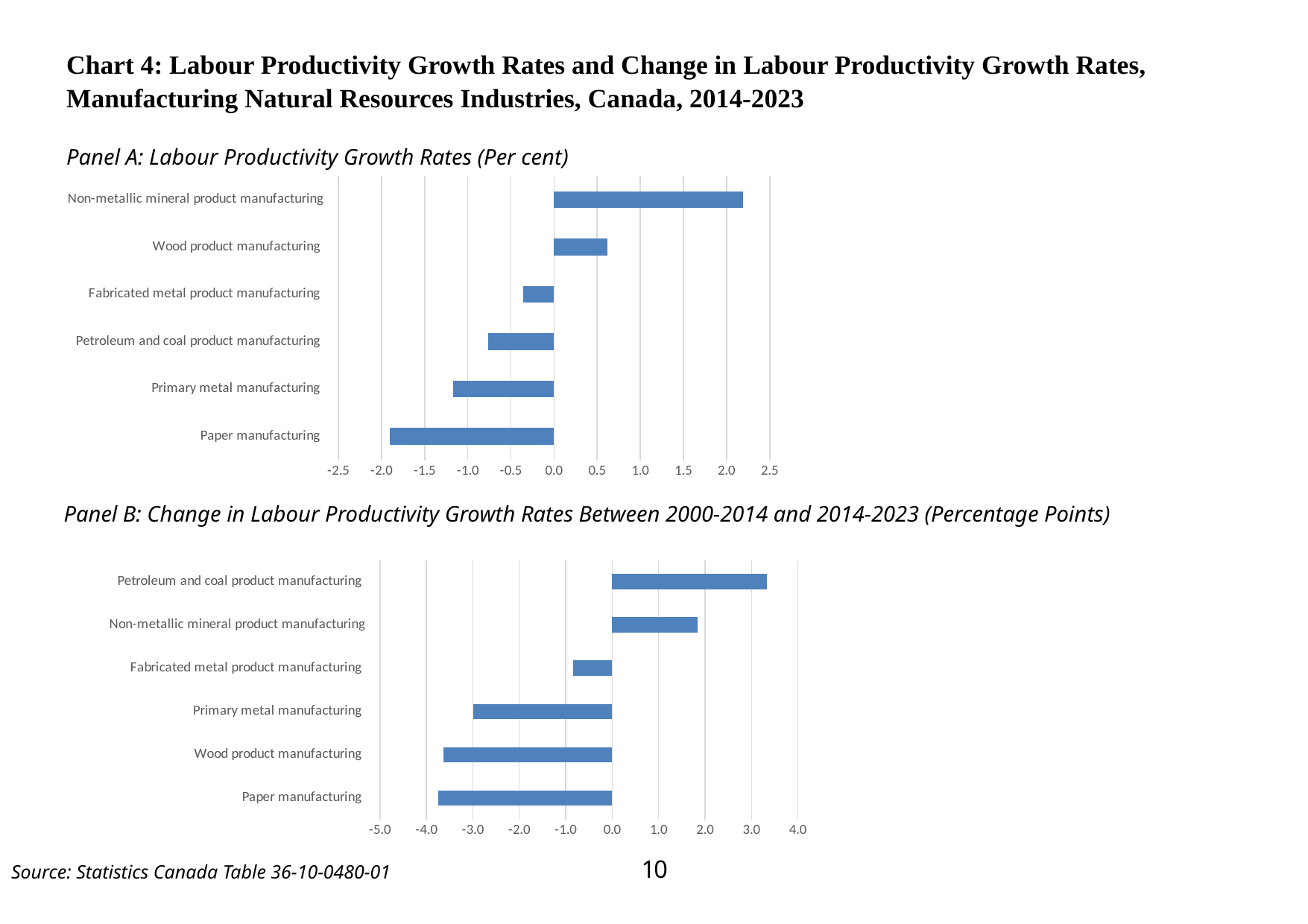
In Panel A, is the value for Non-metallic mineral product manufacturing greater or less than 2.0? greater In Panel A, which has the larger value: Wood product manufacturing or Fabricated metal product manufacturing? Wood product manufacturing In Panel A, how many industries are plotted? 6 In Panel A, which industry has the highest labour productivity growth rate? Non-metallic mineral product manufacturing In Panel A, is the value for Paper manufacturing greater or less than -1.5? less In Panel B, is the value for Petroleum and coal product manufacturing greater or less than 3.0? greater In Panel B, how many industries are plotted? 6 In Panel B, which has the larger value: Primary metal manufacturing or Fabricated metal product manufacturing? Fabricated metal product manufacturing In Panel A, what kind of chart is used to show the labour productivity growth rates? Bar chart In Panel A, which industry has the lowest labour productivity growth rate? Paper manufacturing In Panel B, which industry has the largest change in labour productivity growth rate? Petroleum and coal product manufacturing